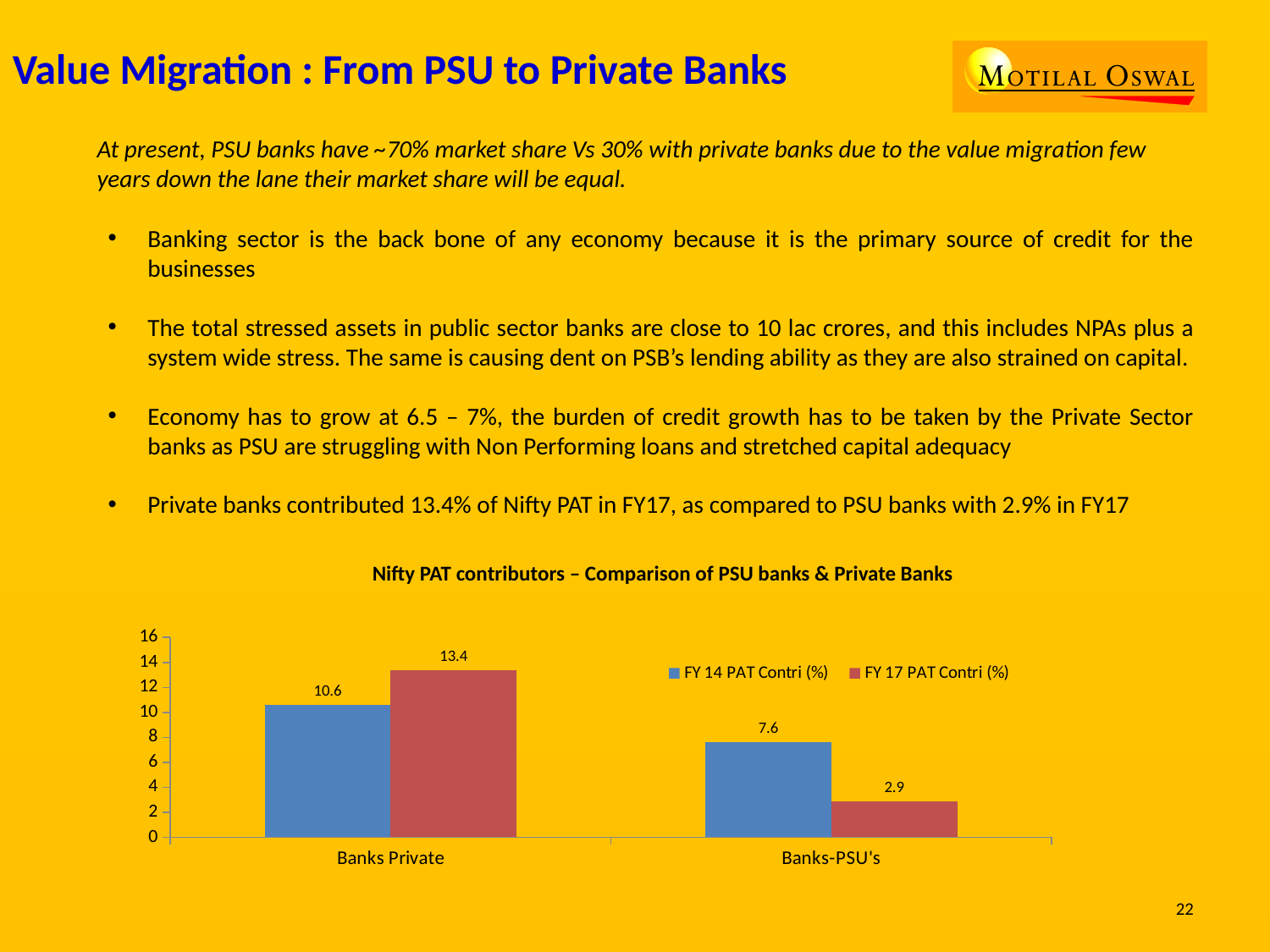
What is the FY 17 PAT Contri (%) value for Banks Private? 13.4 How many series does the chart legend list? 2 Which category has the lowest FY 14 PAT Contri (%) value? Banks-PSU's For Banks-PSU's, which is larger: the FY 14 PAT Contri (%) or the FY 17 PAT Contri (%)? FY 14 PAT Contri (%) What is the FY 14 PAT Contri (%) value for Banks-PSU's? 7.6 What kind of chart is shown on the slide? Bar chart Which category has the highest FY 17 PAT Contri (%) value? Banks Private How many categories are shown on the x axis of the chart? 2 What is the FY 17 PAT Contri (%) value for Banks-PSU's? 2.9 What is the FY 14 PAT Contri (%) value for Banks Private? 10.6 What is the difference between the FY 17 PAT Contri (%) values for Banks Private and Banks-PSU's? 10.5 What is the title of the chart? Nifty PAT contributors – Comparison of PSU banks & Private Banks